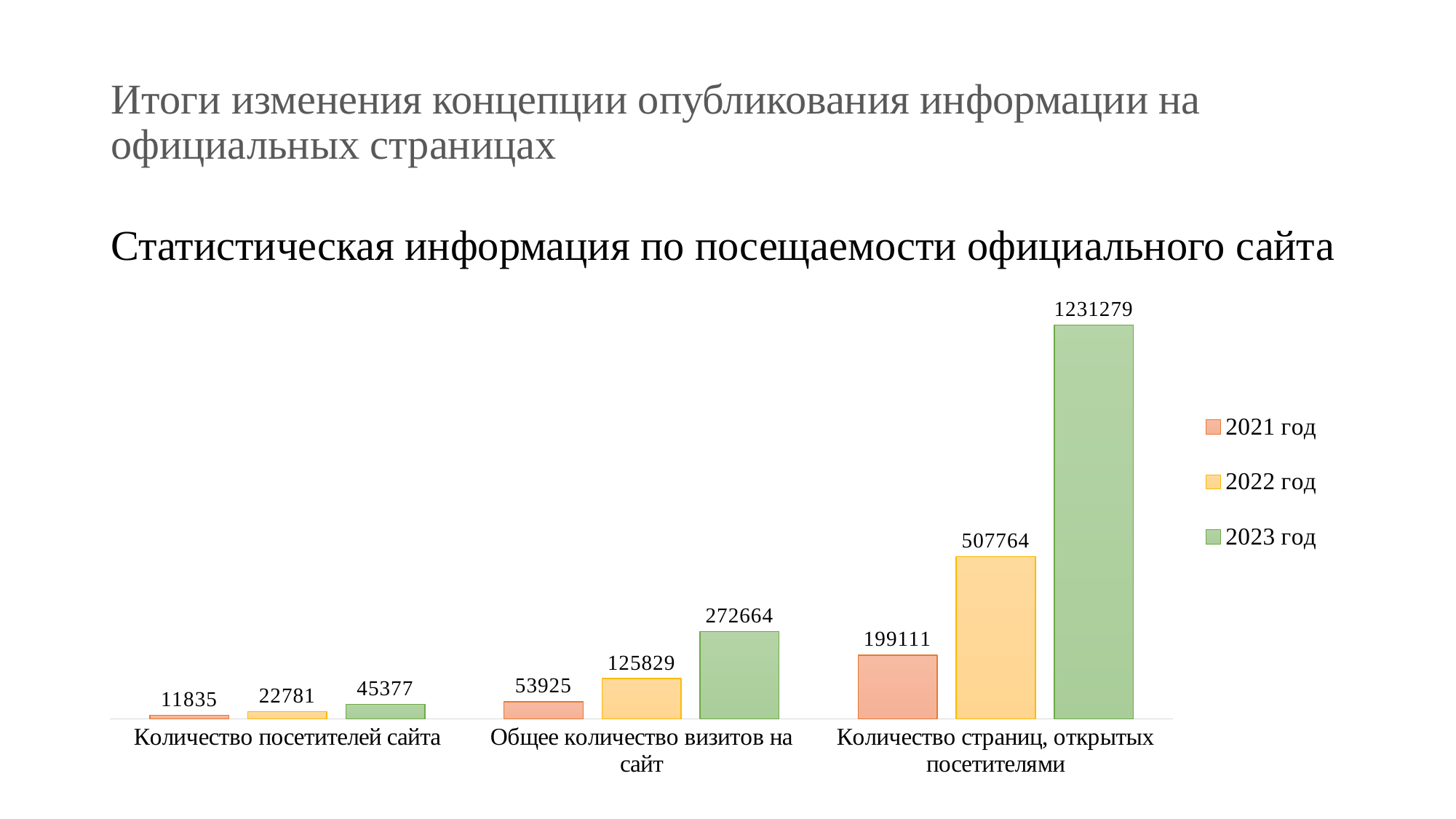
What is the value for 2021 год in the category Общее количество визитов на сайт? 53925 How many series does the legend list? 3 What is the value for 2022 год in the category Количество страниц, открытых посетителями? 507764 What is the value for 2023 год in the category Количество посетителей сайта? 45377 Which is larger: the 2022 год value for Общее количество визитов на сайт or the 2021 год value for Количество страниц, открытых посетителями? 2021 год value for Количество страниц, открытых посетителями What is the difference between the 2023 год and 2022 год values for Количество страниц, открытых посетителями? 723515 Which series has the highest value in the category Количество страниц, открытых посетителями? 2023 год What is the difference between the 2023 год and 2021 год values for Количество посетителей сайта? 33542 Which series has the lowest value in the category Общее количество визитов на сайт? 2021 год What kind of chart is shown on the slide? Bar chart Within each category, do the values rise or fall from 2021 год to 2023 год? Rise How many categories are shown on the x axis? 3